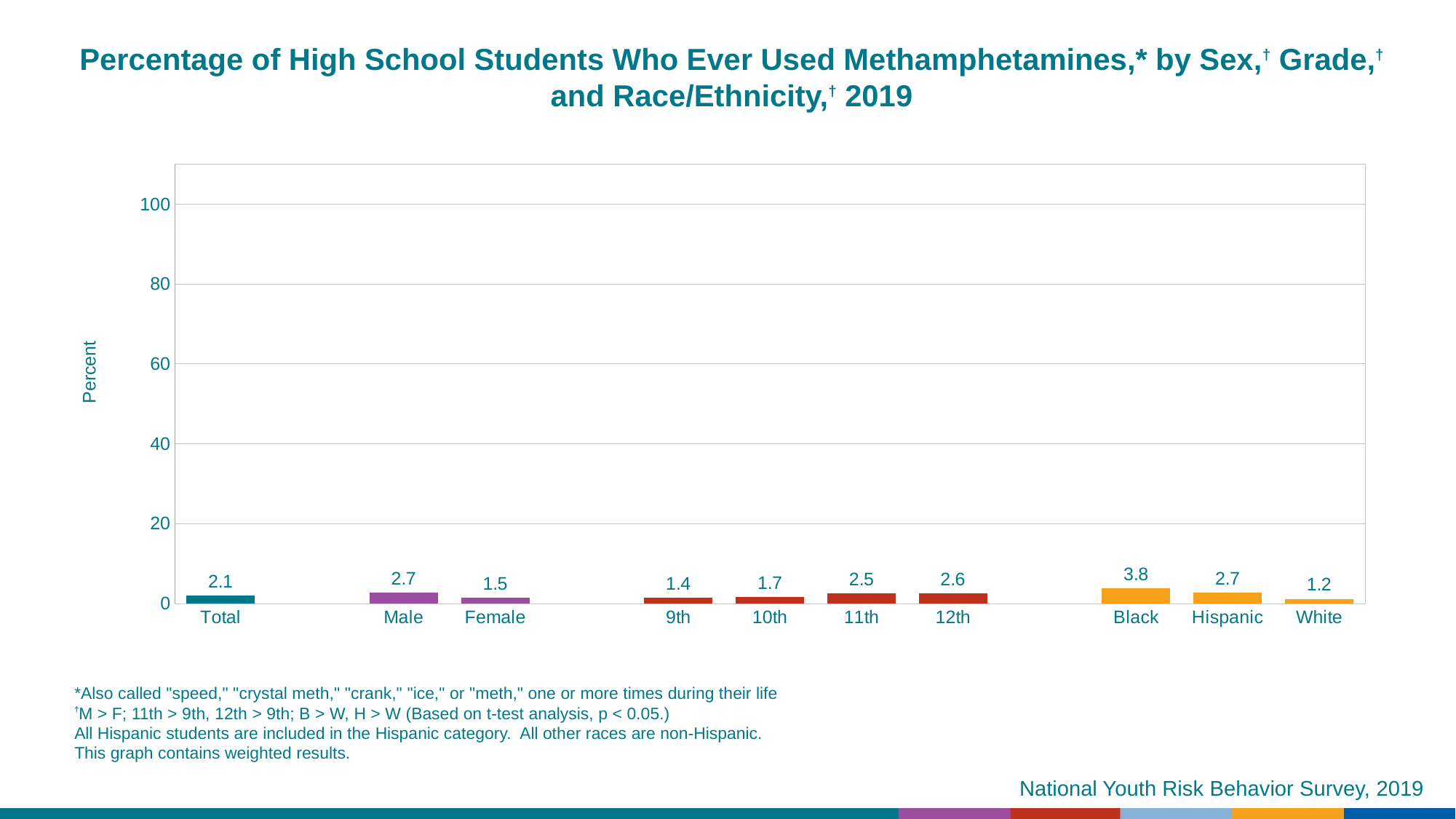
Is the value for Total greater or less than 20? less How many categories are shown on the x axis? 10 Which is larger, the value for 12th grade or the value for 10th grade? 12th What is the value for Male? 2.7 What is the value for 9th grade? 1.4 Which category has the lowest value? White What is the value for Black? 3.8 What is the difference between the values for Black and White? 2.6 What kind of chart is this? bar chart Which category has the highest value? Black What is the label on the y axis? Percent What is the difference between the values for Male and Female? 1.2